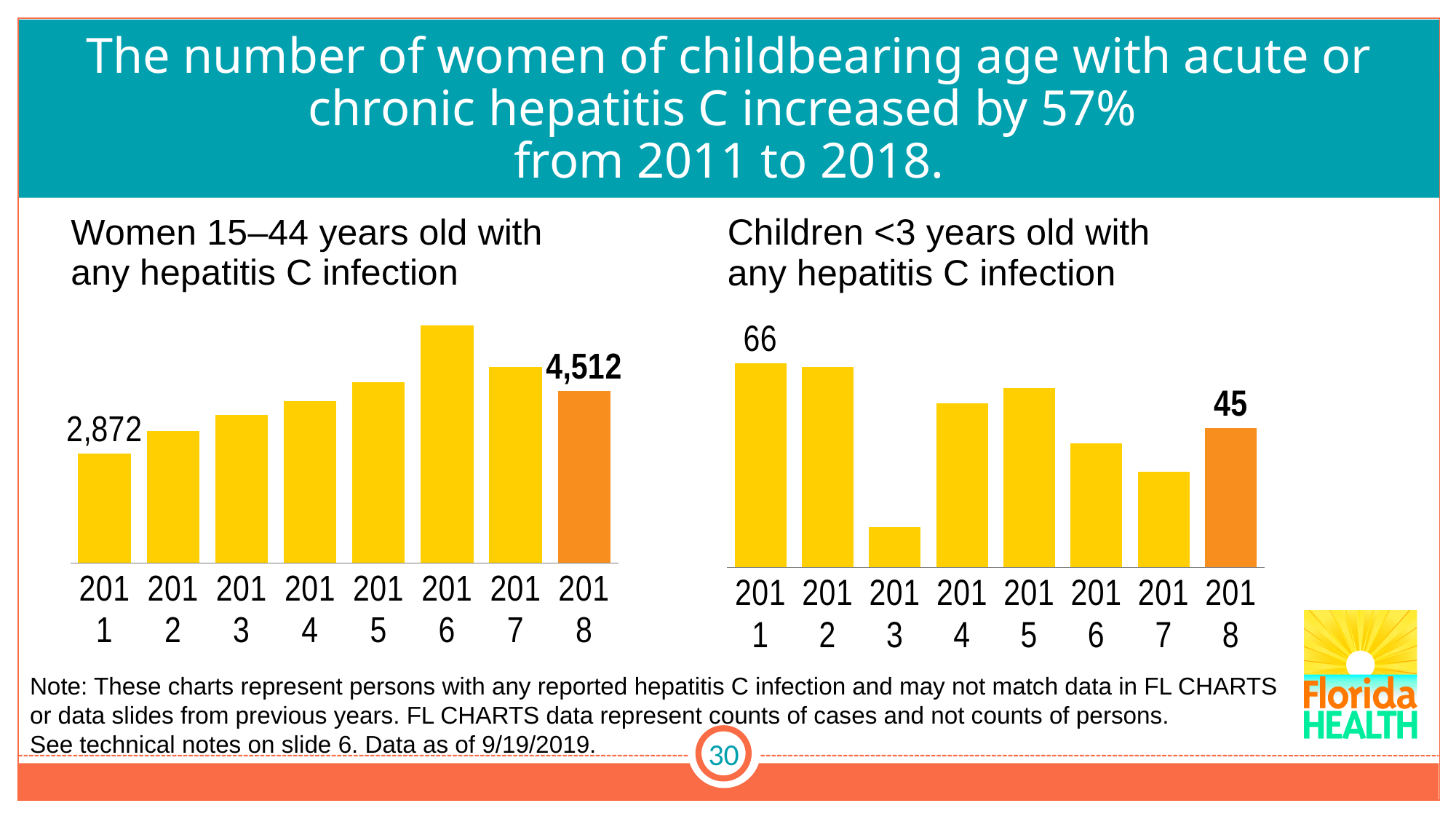
In the chart 'Children <3 years old with any hepatitis C infection', which year has the lowest bar? 2013 In the chart 'Women 15–44 years old with any hepatitis C infection', what is the value for 2011? 2,872 In the chart 'Children <3 years old with any hepatitis C infection', what is the difference between the 2011 and 2018 values? 21 In the chart 'Women 15–44 years old with any hepatitis C infection', which year has the lowest bar? 2011 In the chart 'Women 15–44 years old with any hepatitis C infection', by how much does the 2018 value exceed the 2011 value? 1,640 In the chart 'Children <3 years old with any hepatitis C infection', what is the value for 2018? 45 In the chart 'Women 15–44 years old with any hepatitis C infection', what is the value for 2018? 4,512 How many years are shown in the chart 'Women 15–44 years old with any hepatitis C infection'? 8 In the chart 'Children <3 years old with any hepatitis C infection', what is the value for 2011? 66 In the chart 'Children <3 years old with any hepatitis C infection', which is larger, the value for 2013 or the value for 2017? 2017 In the chart 'Children <3 years old with any hepatitis C infection', which year has the highest bar? 2011 In the chart 'Women 15–44 years old with any hepatitis C infection', which year has the highest bar? 2016